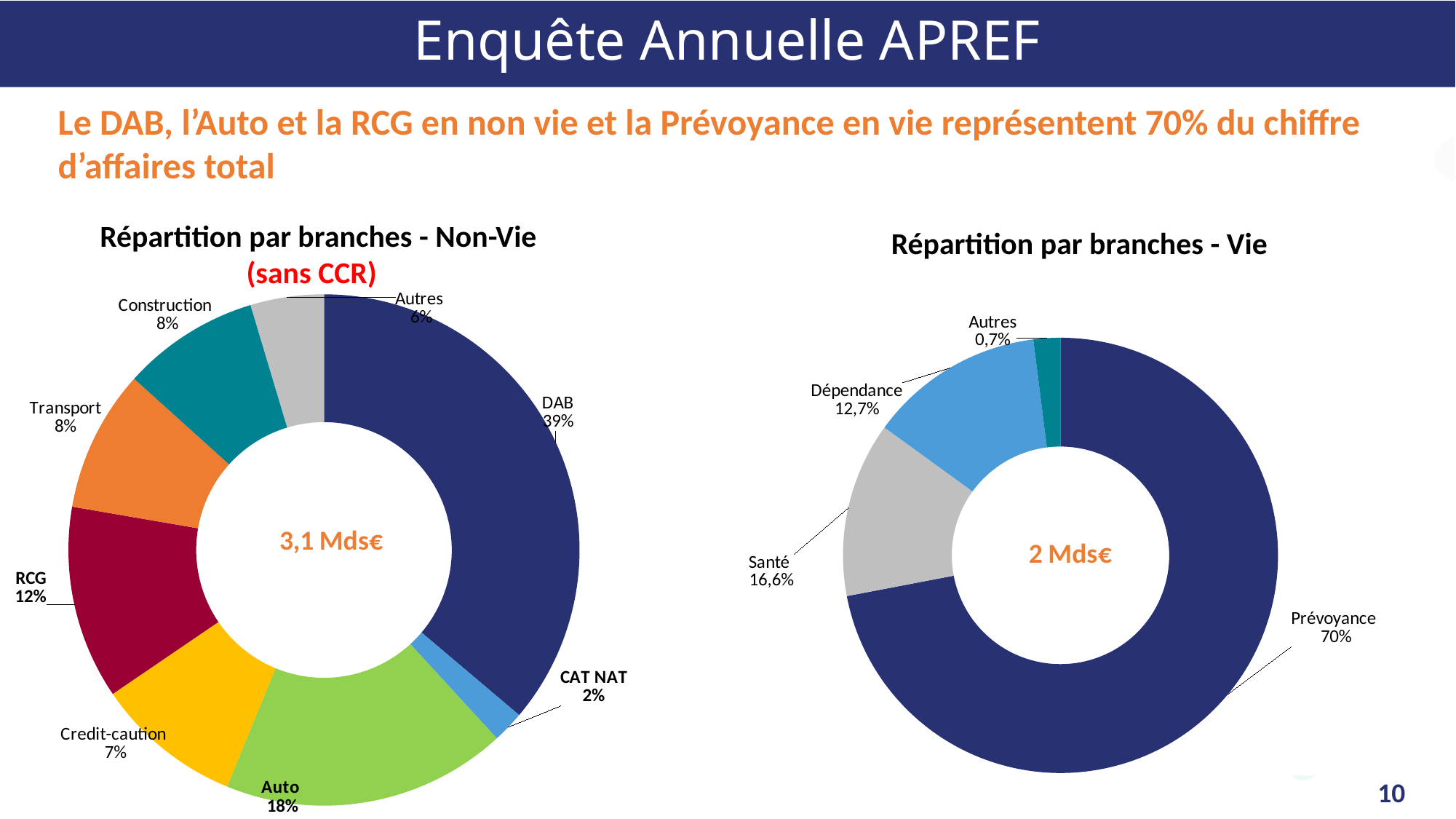
In the 'Répartition par branches - Vie' chart, which branch has the smallest share? Autres In the 'Répartition par branches - Non-Vie' chart, what share does DAB represent? 39% In the 'Répartition par branches - Vie' chart, what share does Prévoyance represent? 70% In the 'Répartition par branches - Non-Vie' chart, what is the difference between the shares of RCG and Credit-caution? 5% In the 'Répartition par branches - Non-Vie' chart, which branch has the smallest share? CAT NAT In the 'Répartition par branches - Vie' chart, which is larger, Dépendance or Santé? Santé In the 'Répartition par branches - Non-Vie' chart, what total amount is shown in the centre of the donut? 3,1 Mds€ In the 'Répartition par branches - Vie' chart, what share does Santé represent? 16,6% What type of chart is used for 'Répartition par branches - Vie'? Pie (donut) chart In the 'Répartition par branches - Non-Vie' chart, how many branches are shown? 8 In the 'Répartition par branches - Non-Vie' chart, which branch has the largest share? DAB In the 'Répartition par branches - Non-Vie' chart, what share does Auto represent? 18%